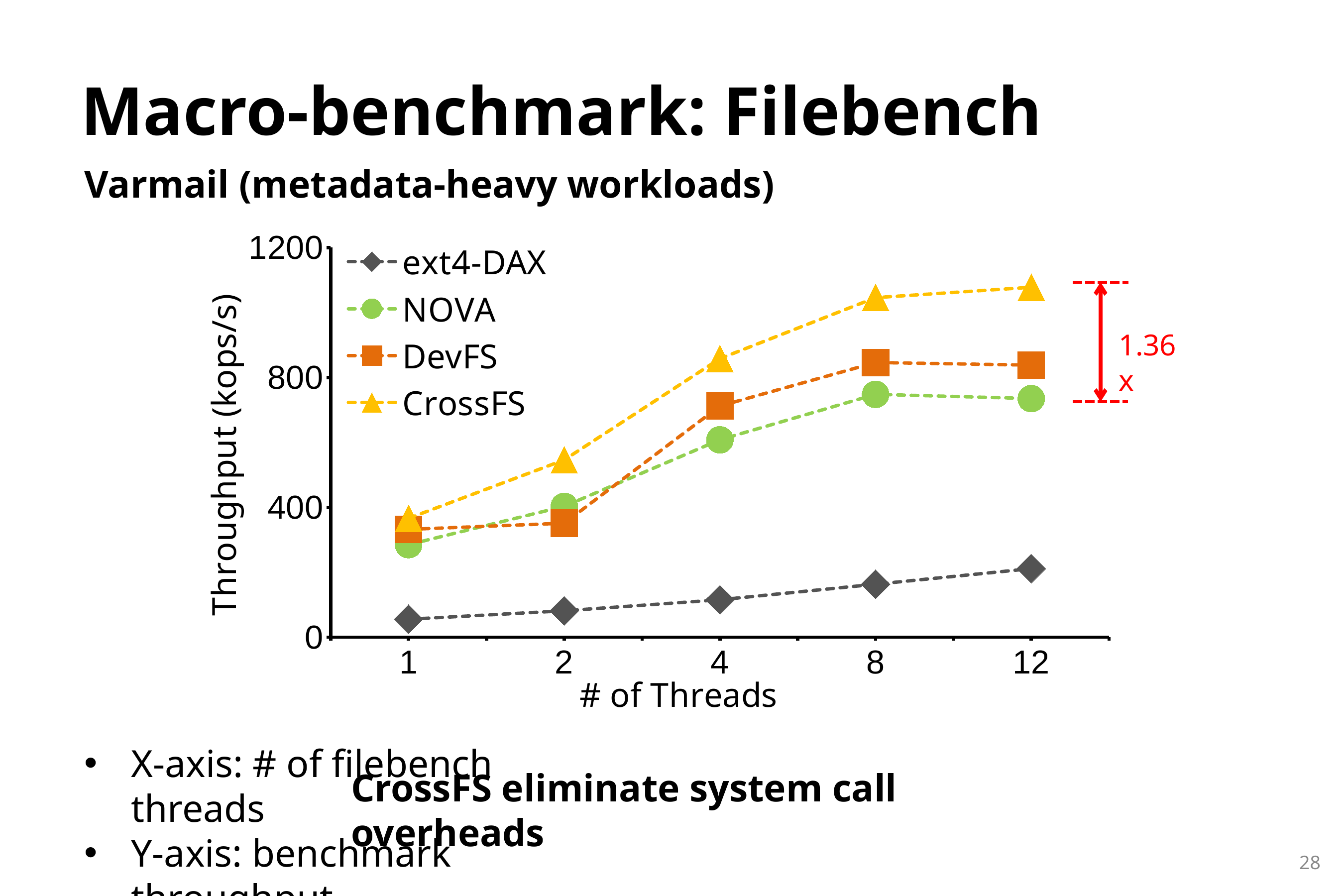
What speedup factor is annotated in red between CrossFS and NOVA at 12 threads? 1.36x At 4 threads, which has higher throughput, DevFS or NOVA? DevFS What kind of chart is shown on the slide? line chart Is the throughput of NOVA at 4 threads greater or less than 400 kops/s? greater Is the throughput of ext4-DAX at 12 threads greater or less than 400 kops/s? less How many thread counts are plotted along the x axis? 5 How many series does the legend list? 4 What is the label of the y axis? Throughput (kops/s) Does the throughput of ext4-DAX rise or fall as the number of threads increases? rise Which series has the lowest throughput at 8 threads? ext4-DAX Which series has the highest throughput at 12 threads? CrossFS Is the throughput of CrossFS at 12 threads greater or less than 800 kops/s? greater